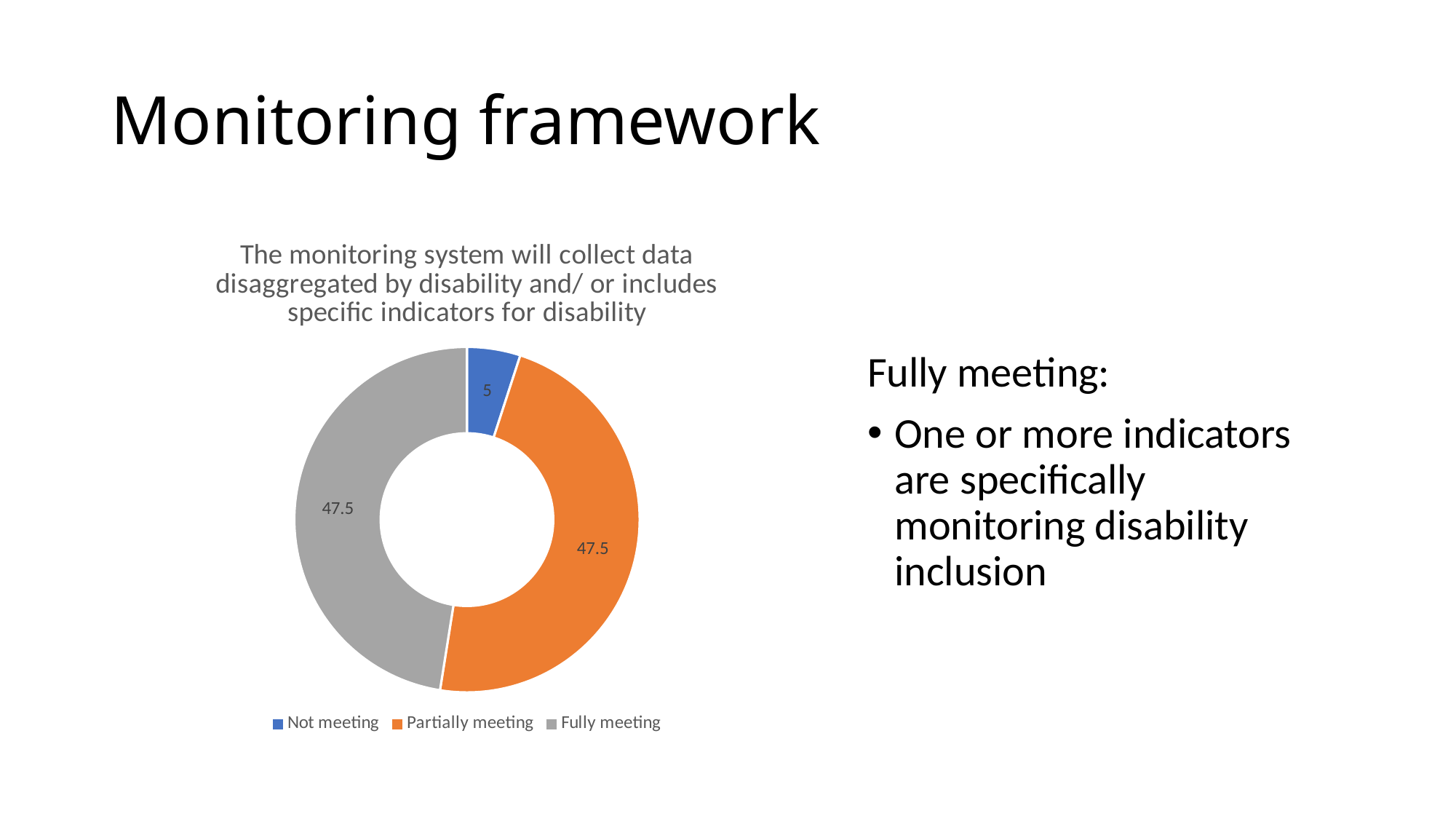
What is the difference between the values for Partially meeting and Not meeting? 42.5 How many entries does the chart legend list? 3 What is the value for Fully meeting in the chart? 47.5 What is the value for Partially meeting in the chart? 47.5 What is the total of the three values shown in the chart? 100 What kind of chart is shown on the slide? Doughnut chart How many categories are shown in the chart? 3 What is the value for Not meeting in the chart? 5 What colour represents Fully meeting in the chart? Grey Are the values for Partially meeting and Fully meeting equal? Yes Which is larger, the value for Fully meeting or the value for Not meeting? Fully meeting Which category has the lowest value in the chart? Not meeting